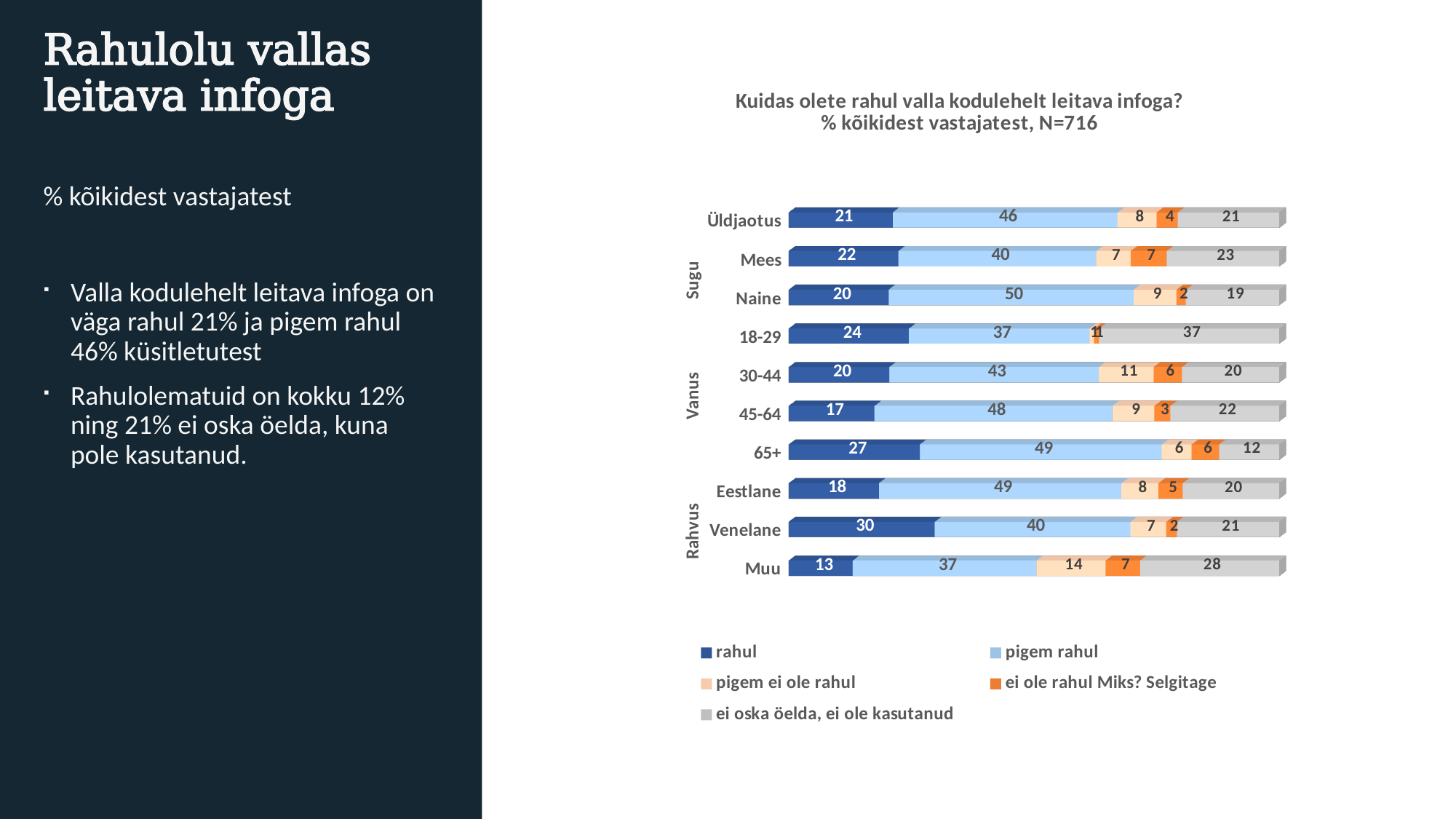
Which category has the highest value for "rahul"? Venelane Which category has the lowest value for "rahul"? Muu Which has a larger "ei oska öelda, ei ole kasutanud" value, Muu or 65+? Muu What is the total of the Üldjaotus stacked bar? 100 What kind of chart is shown on the slide? Stacked bar chart What is the value for "pigem rahul" in the Naine bar? 50 How many series does the legend list? 5 What is the N value stated in the chart title? N=716 What is the value for "rahul" in the Üldjaotus bar? 21 What is the value for "ei oska öelda, ei ole kasutanud" in the 18-29 bar? 37 What is the difference between the "pigem rahul" values for Naine and Mees? 10 How many categories are shown on the chart? 10